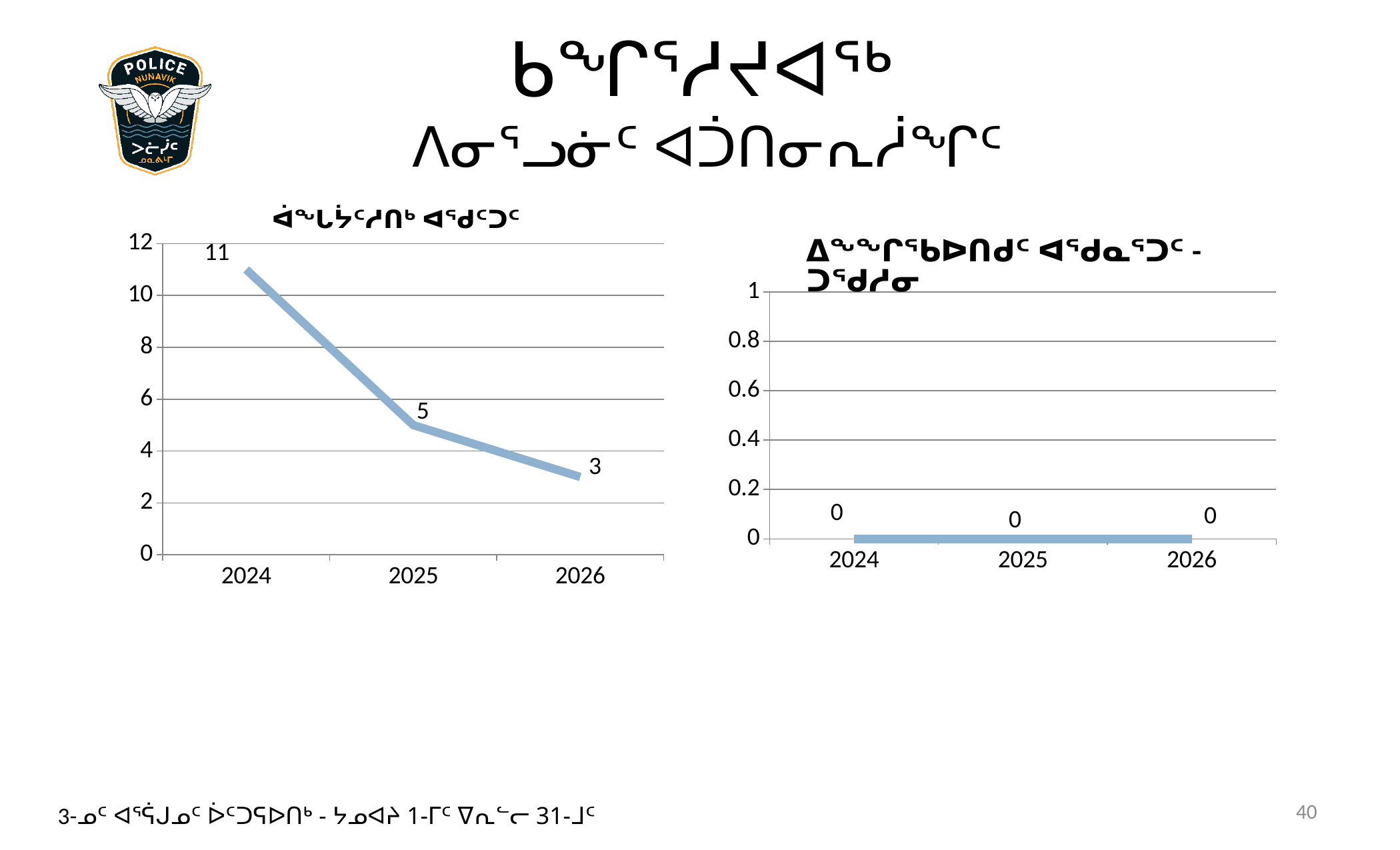
In the left chart, what is the value for 2024? 11 In the left chart, which year has the highest value? 2024 In the left chart, what is the value for 2026? 3 In the right chart, what is the value for 2025? 0 In the left chart, what is the value for 2025? 5 In the left chart, which is larger, the value for 2025 or the value for 2026? 2025 How many years are plotted on the left chart? 3 In the right chart, what is the total of the values for 2024, 2025 and 2026? 0 In the left chart, what is the difference between the values for 2024 and 2025? 6 In the left chart, which year has the lowest value? 2026 What kind of chart is the left chart? line chart In the left chart, do the values rise or fall from 2024 to 2026? fall